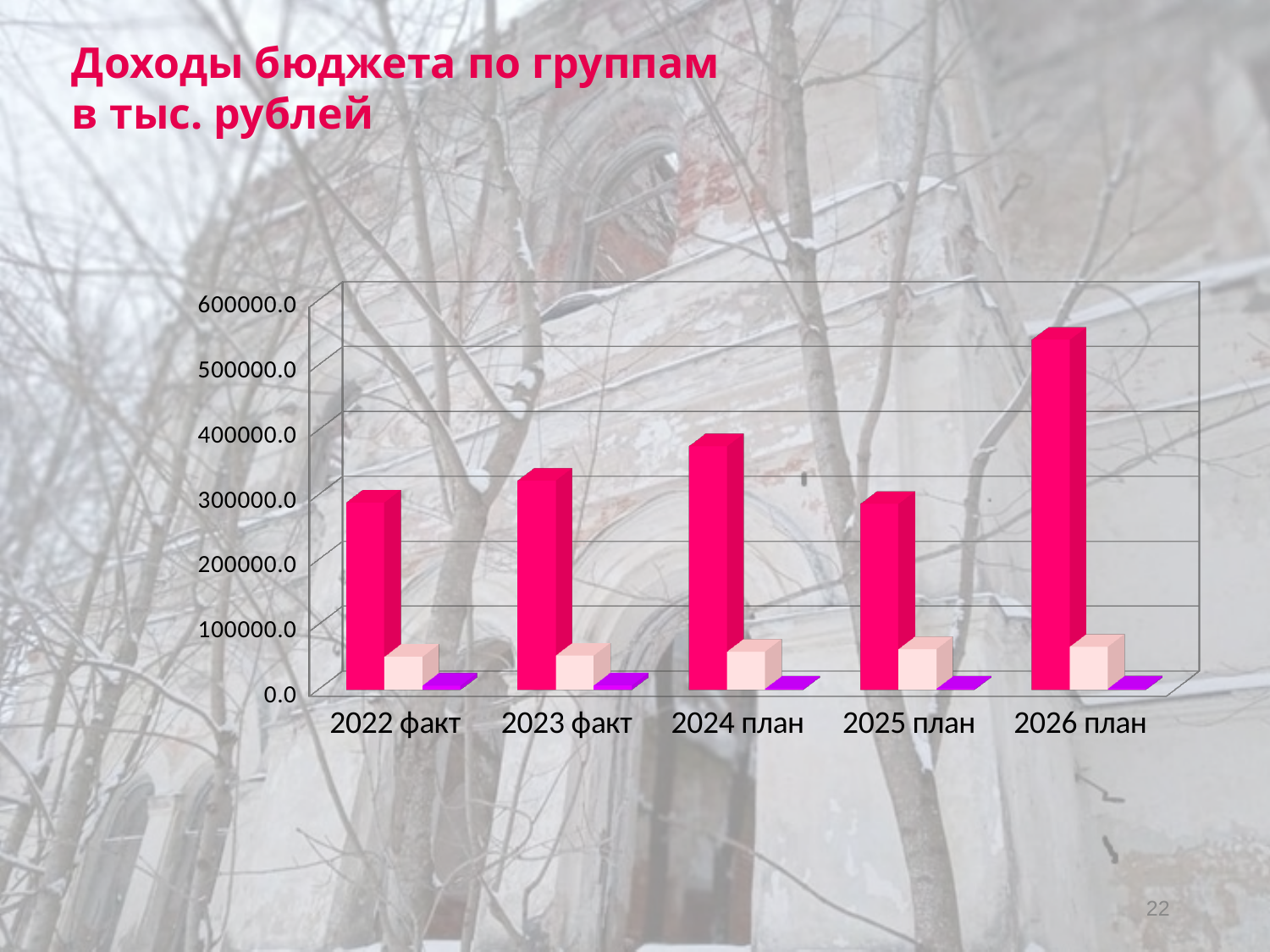
Which has the larger magenta bar, 2023 факт or 2024 план? 2024 план Is the light pink bar for 2026 план greater or less than 100000.0? less What kind of chart is shown on the slide? bar chart Which category has the tallest magenta bar? 2026 план Is the magenta bar for 2024 план greater or less than 300000.0? greater Is the magenta bar for 2024 план greater or less than 400000.0? less How many differently coloured bar series are plotted for each category? 3 What is the title of the chart on the slide? Доходы бюджета по группам в тыс. рублей How many categories are shown on the x axis of the chart? 5 Does the magenta bar rise or fall from 2024 план to 2025 план? fall